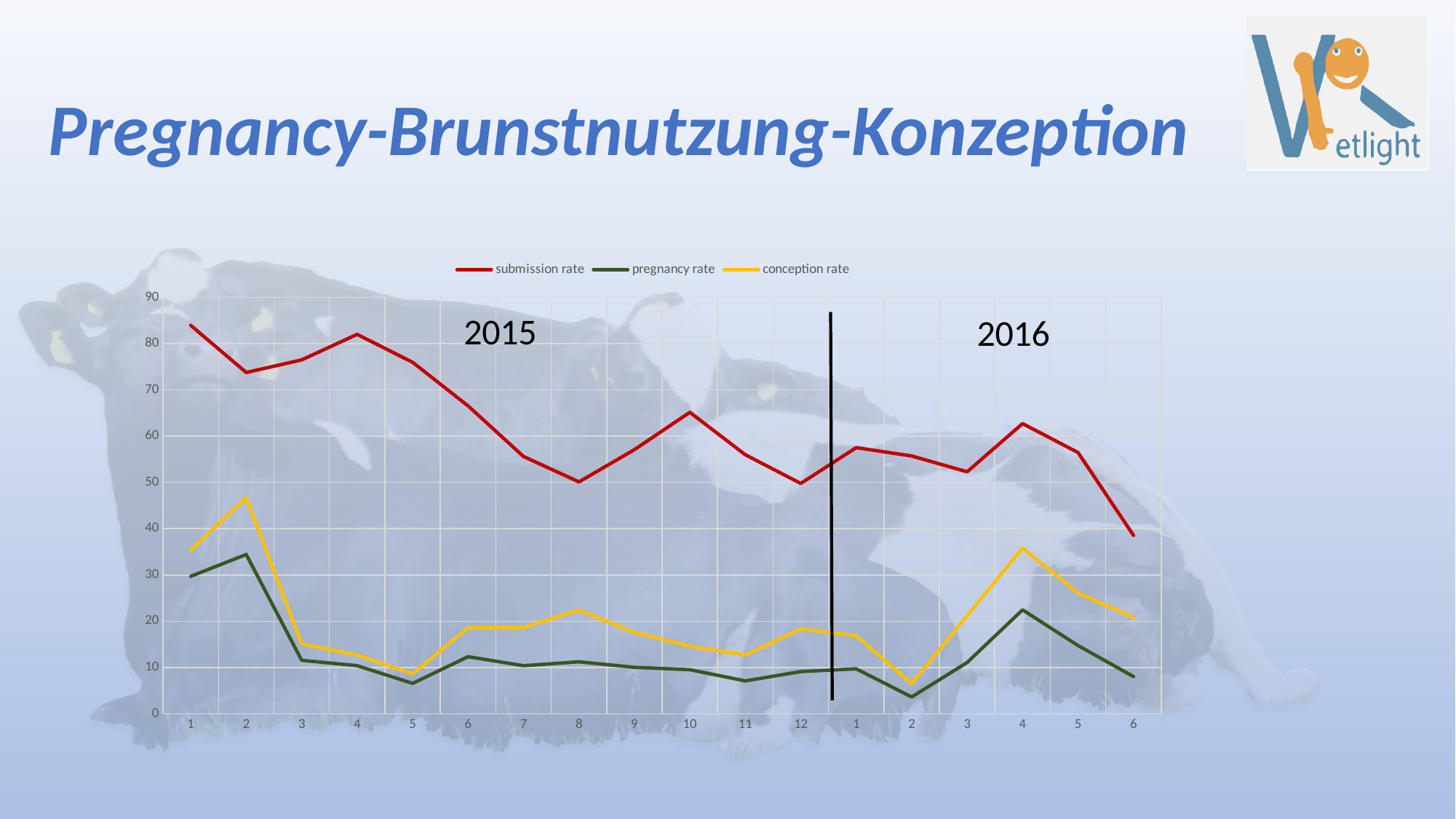
Is the pregnancy rate at month 2 of 2016 greater or less than 10? less What kind of chart is shown on the slide? line chart How many points are plotted along the x axis for each series? 18 What colour is the submission rate line? red At which month is the submission rate lowest? month 6 of 2016 Is the conception rate at month 2 of 2015 greater or less than 40? greater Does the submission rate rise or fall from month 4 to month 6 of 2016? fall How many series does the legend list? 3 At month 2 of 2015, which is higher: the conception rate or the pregnancy rate? conception rate Is the submission rate at month 1 of 2015 greater or less than 80? greater At which month is the conception rate highest? month 2 of 2015